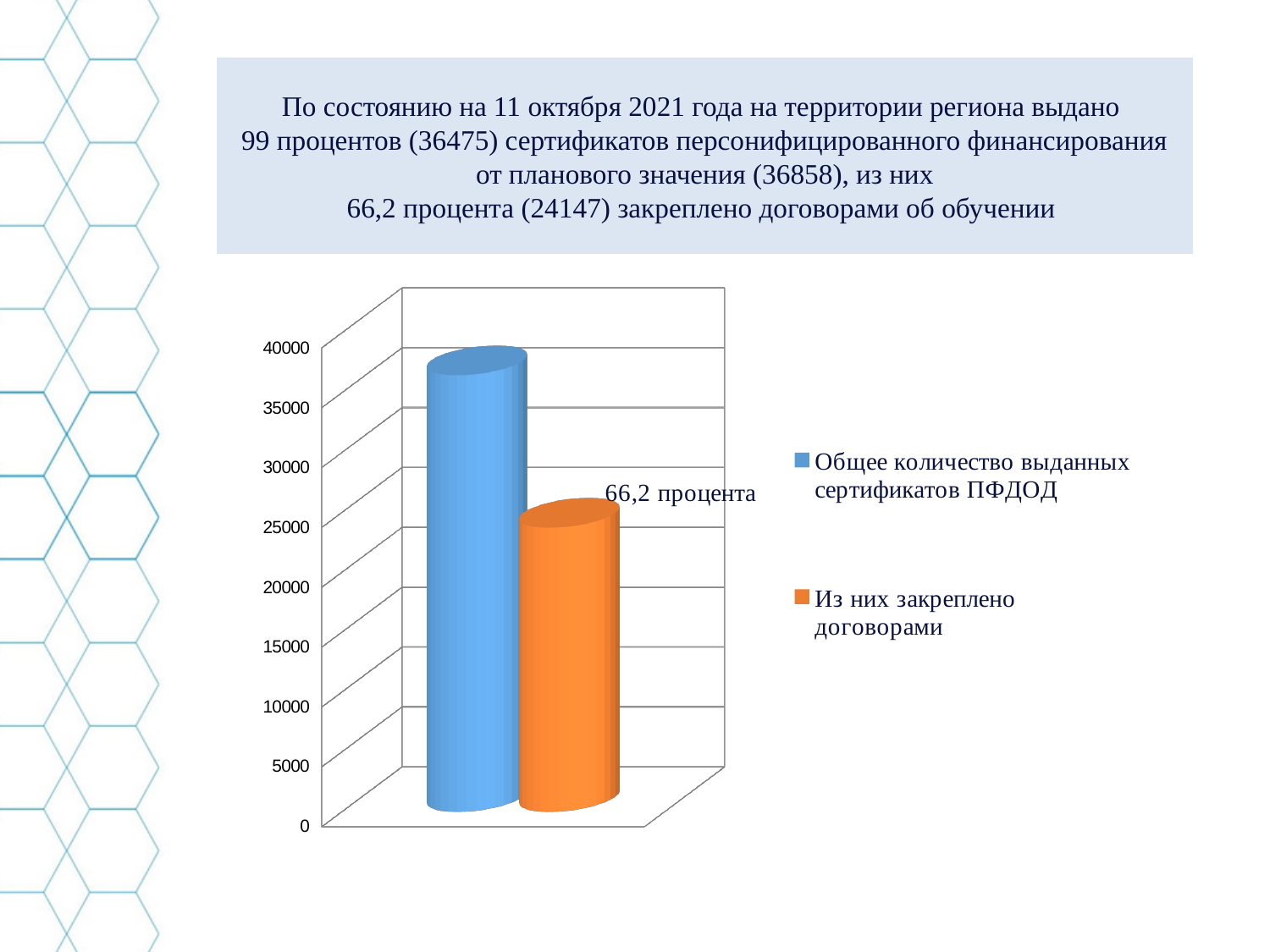
What data label is shown next to the orange bar in the chart? 66,2 процента Is the value for 'Общее количество выданных сертификатов ПФДОД' greater or less than 30000? greater Which series has the shorter bar in the chart? Из них закреплено договорами What kind of chart is shown on the slide? bar chart Is the value for 'Из них закреплено договорами' greater or less than 20000? greater What colour is the bar for 'Из них закреплено договорами'? orange How many series does the chart legend list? 2 What is the highest value shown on the vertical axis of the chart? 40000 Is the value for 'Общее количество выданных сертификатов ПФДОД' greater or less than 40000? less Which series has the taller bar in the chart? Общее количество выданных сертификатов ПФДОД Is the bar for 'Общее количество выданных сертификатов ПФДОД' larger or smaller than the bar for 'Из них закреплено договорами'? larger